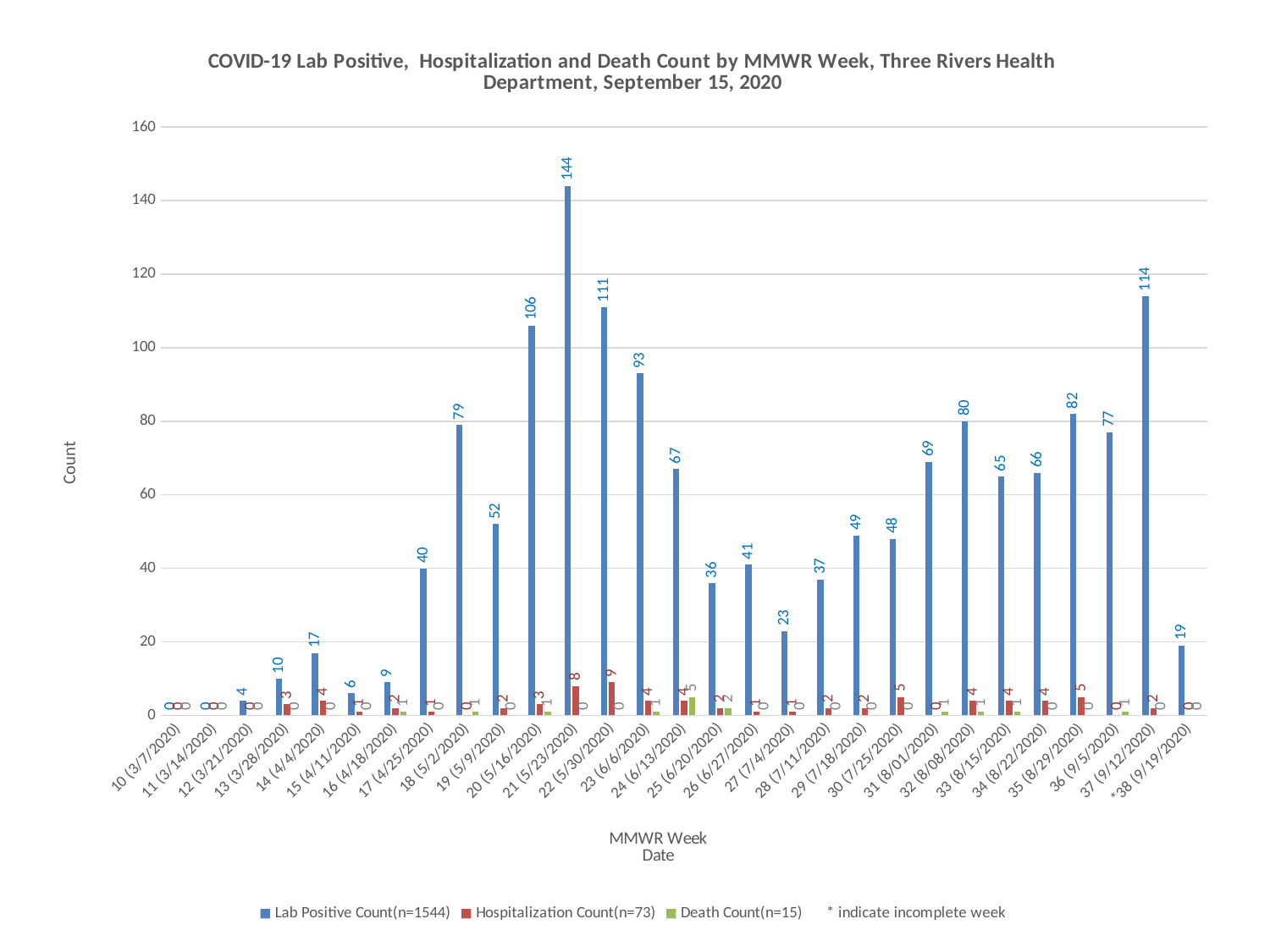
According to the legend, what is the total n for the Hospitalization Count series? 73 What is the difference between the Lab Positive Count for week 37 (9/12/2020) and week 36 (9/5/2020)? 37 Do the Lab Positive Counts rise or fall from week 17 (4/25/2020) to week 21 (5/23/2020)? Rise Which is larger, the Lab Positive Count for week 20 (5/16/2020) or for week 22 (5/30/2020)? 22 (5/30/2020) What is the Lab Positive Count for the incomplete week *38 (9/19/2020)? 19 What kind of chart is shown on the slide? Bar chart What is the Hospitalization Count for MMWR week 22 (5/30/2020)? 9 Which MMWR week has the highest Lab Positive Count? 21 (5/23/2020) What is the Lab Positive Count for MMWR week 21 (5/23/2020)? 144 What is the Death Count for MMWR week 24 (6/13/2020)? 5 How many MMWR weeks are shown on the x axis? 29 How many series does the legend list? 3